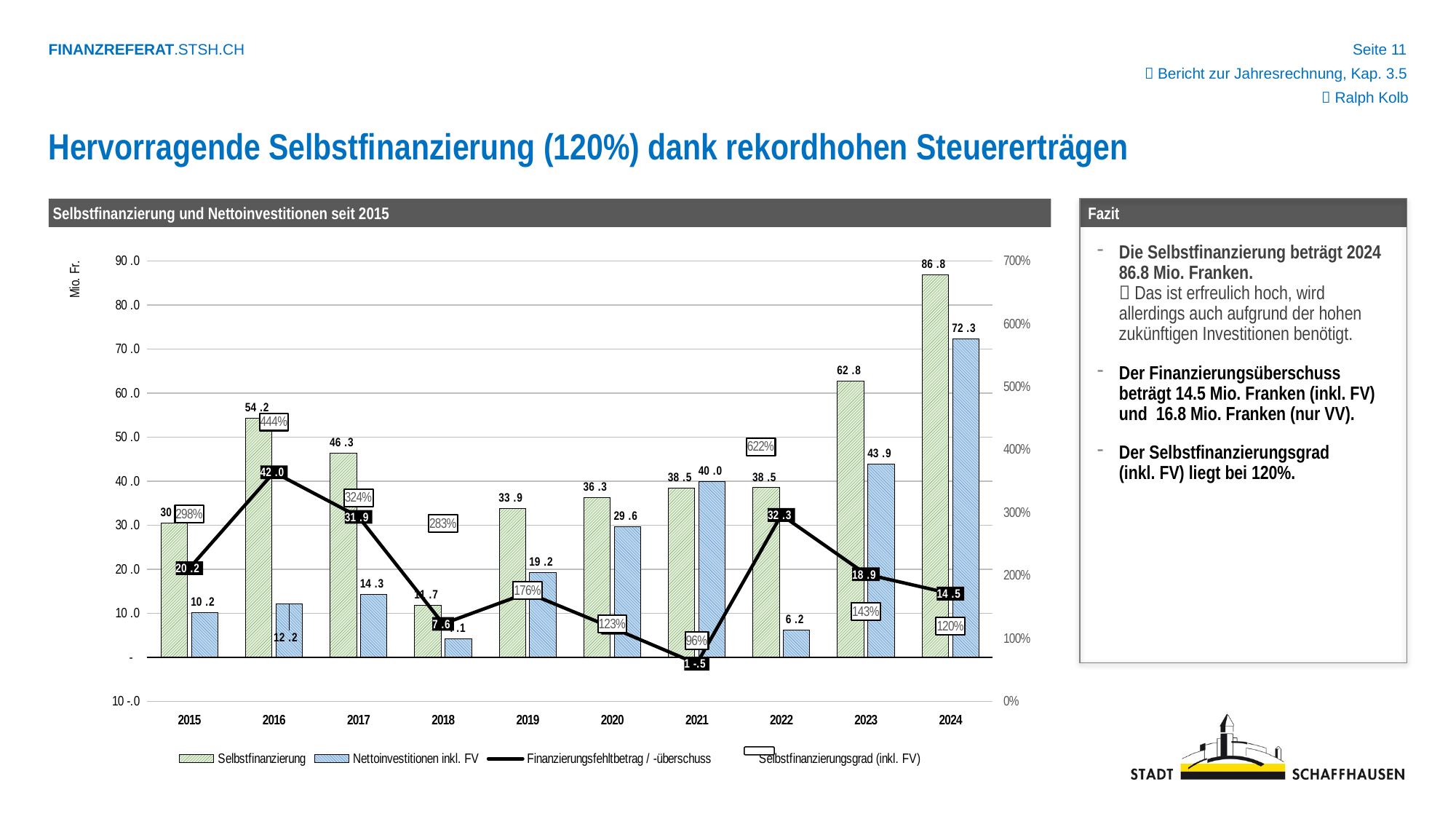
What is the Nettoinvestitionen inkl. FV value for 2021? 40.0 How many series does the legend list? 4 In which year is the Selbstfinanzierungsgrad (inkl. FV) highest? 2022 In 2021, which is larger: Selbstfinanzierung or Nettoinvestitionen inkl. FV? Nettoinvestitionen inkl. FV In which year is Selbstfinanzierung highest? 2024 What is the difference between Selbstfinanzierung and Nettoinvestitionen inkl. FV in 2024? 14.5 In which year is Selbstfinanzierung lowest? 2018 What is the Finanzierungsfehlbetrag / -überschuss value for 2021? -1.5 How many years are shown on the x axis? 10 What is the Selbstfinanzierung value for 2024? 86.8 What is the Selbstfinanzierungsgrad (inkl. FV) for 2022? 622% What kind of chart is shown? Combined bar and line chart